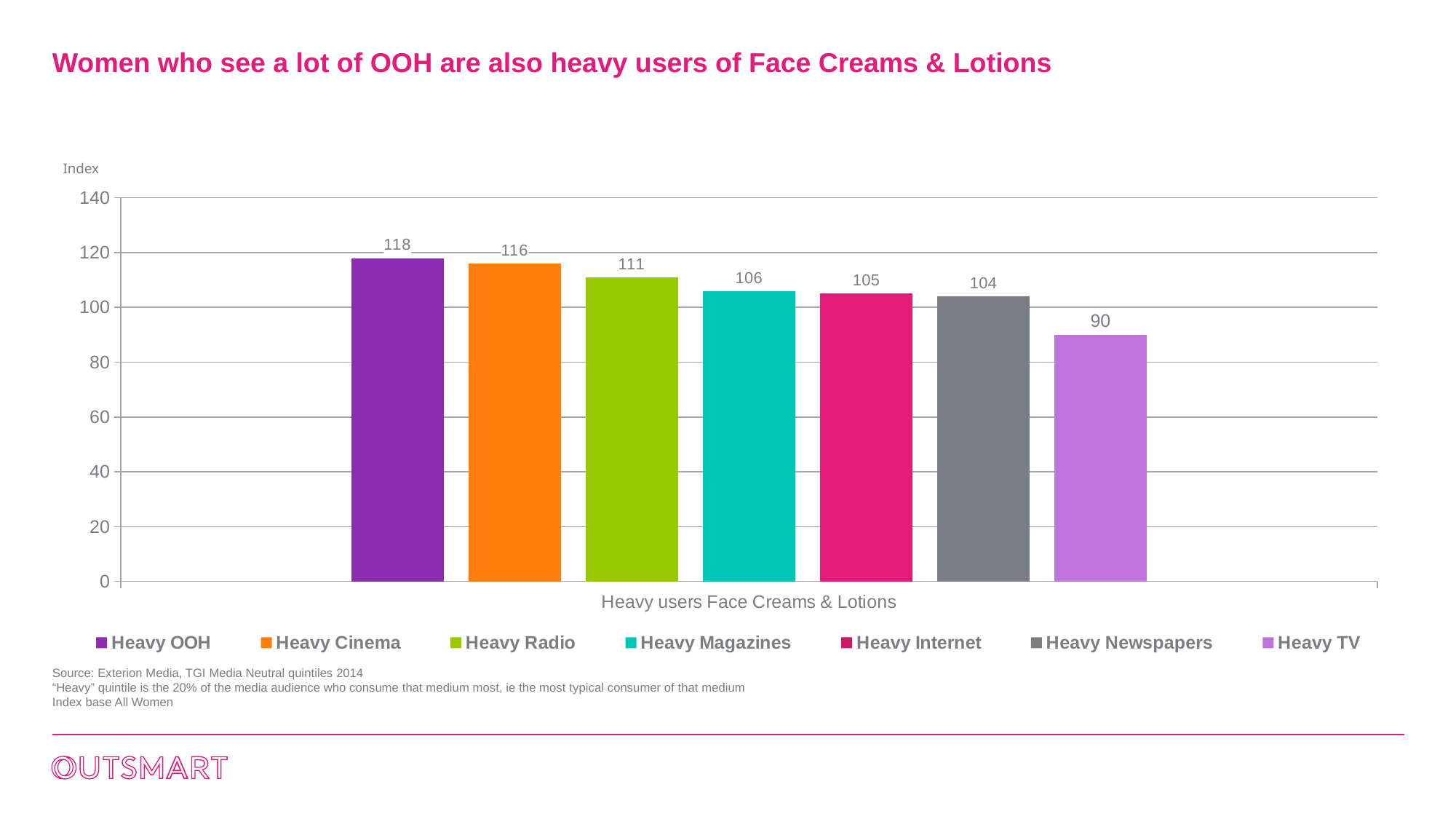
Which has a larger index value, Heavy Radio or Heavy Newspapers? Heavy Radio What is the index value for Heavy TV? 90 What is the index value for Heavy Magazines? 106 What is the difference between the index values for Heavy Cinema and Heavy Radio? 5 How many series does the legend list? 7 Which series has the highest index value? Heavy OOH What kind of chart is shown on the slide? Bar chart Is the value for Heavy Internet greater or less than 100? greater What is the difference between the index values for Heavy OOH and Heavy TV? 28 Which series has the lowest index value? Heavy TV What is the label on the x axis of the chart? Heavy users Face Creams & Lotions What is the index value for Heavy OOH? 118